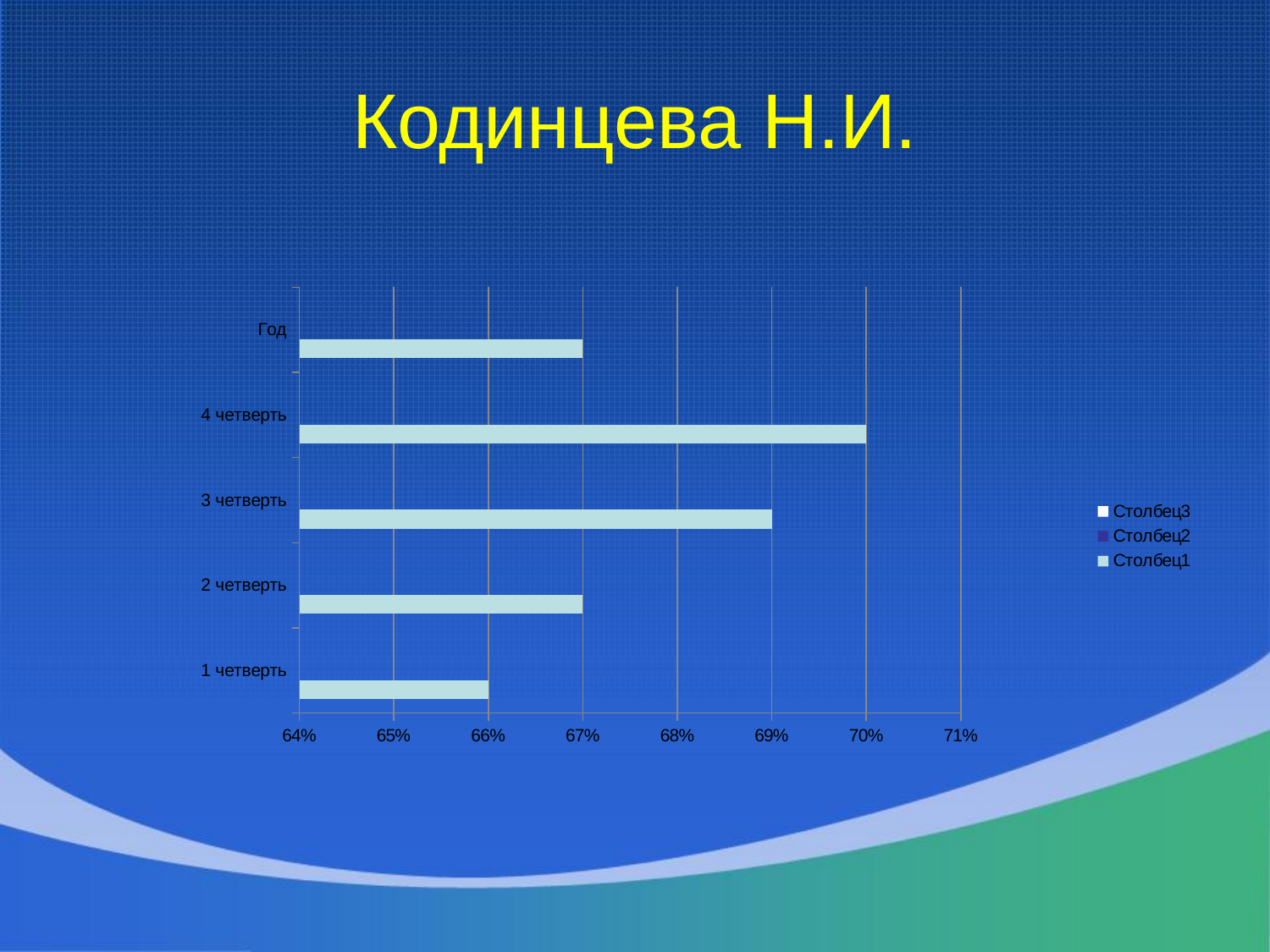
How many series does the legend list? 3 What is the difference between the values for 4 четверть and 1 четверть? 4% Which is larger, the value for 3 четверть or the value for 2 четверть? 3 четверть What is the value for 3 четверть? 69% What is the value for Год? 67% Which category has the lowest value? 1 четверть Is the value for 3 четверть greater or less than 68%? greater What is the value for 4 четверть? 70% How many categories are shown on the chart? 5 What is the value for 1 четверть? 66% Which category has the highest value? 4 четверть What kind of chart is shown on the slide? Bar chart